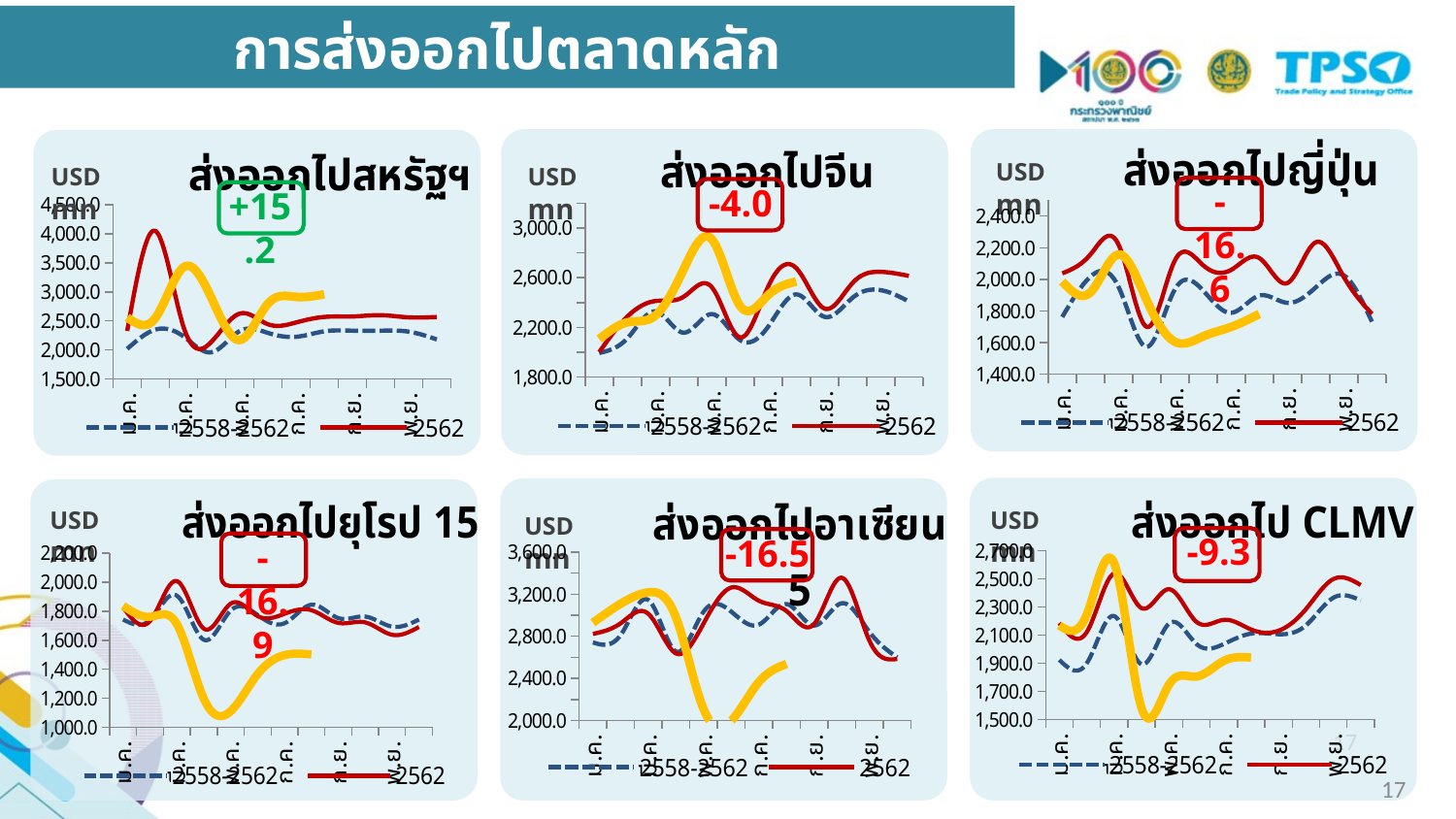
In the 'ส่งออกไป CLMV' chart, is the peak of the yellow line greater or less than 2,500.0? greater In the 'ส่งออกไปสหรัฐฯ' chart, what growth figure is printed in the box? +15.2 What is the unit label shown on the y axis of each chart? USD mn In the 'ส่งออกไปญี่ปุ่น' chart, what figure is printed in the box? -16.6 In the 'ส่งออกไปยุโรป 15' chart, what figure is printed in the box? -16.9 In the 'ส่งออกไปยุโรป 15' chart, is the lowest point of the yellow line greater or less than 1,400.0? less How many charts are shown on the slide? 6 In the 'ส่งออกไป CLMV' chart, what figure is printed in the box? -9.3 What is the highest y-axis tick value on the 'ส่งออกไปอาเซียน' chart? 3,600.0 In the 'ส่งออกไปสหรัฐฯ' chart, is the peak of the yellow line greater or less than 3,000.0? greater What kind of chart is used in the 'ส่งออกไปสหรัฐฯ' panel? line chart In the 'ส่งออกไปจีน' chart, what figure is printed in the box? -4.0